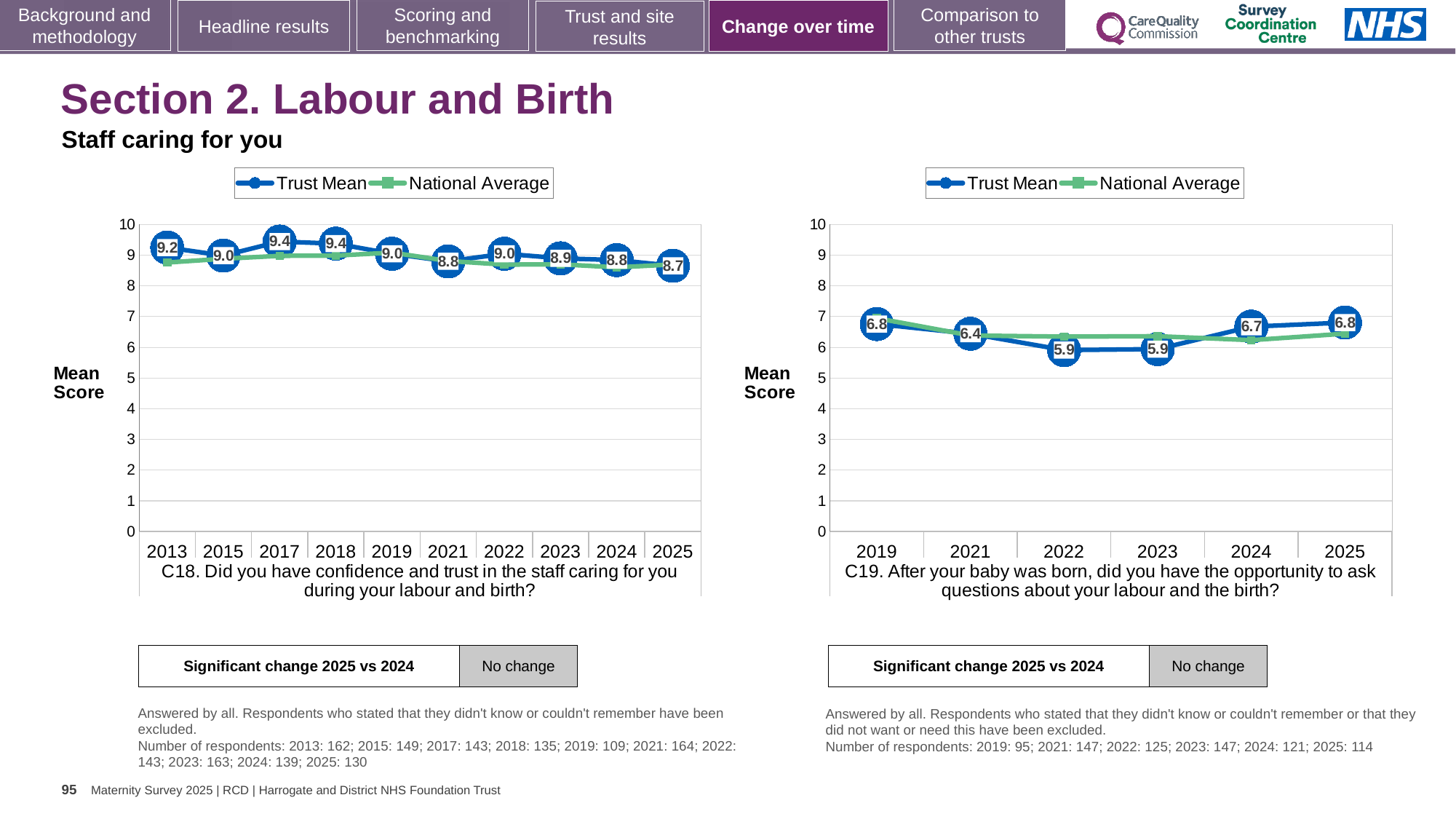
In the C18 chart on the left, what is the Trust Mean for 2025? 8.7 How many series does the legend of the C19 chart on the right list? 2 In the C19 chart on the right, what is the Trust Mean for 2022? 5.9 In the C19 chart on the right, which is larger, the Trust Mean for 2021 or for 2024? 2024 In the C18 chart on the left, what is the difference between the Trust Mean for 2017 and for 2025? 0.7 In the C18 chart on the left, which year has the lowest Trust Mean? 2025 In the C19 chart on the right, does the Trust Mean rise or fall from 2022 to 2025? rise What kind of chart is the C18 chart on the left? line chart In the C19 chart on the right, what is the Trust Mean for 2024? 6.7 How many years are plotted in the C18 chart on the left? 10 In the C19 chart on the right, what is the difference between the Trust Mean for 2019 and for 2022? 0.9 In the C18 chart on the left, what is the Trust Mean for 2017? 9.4